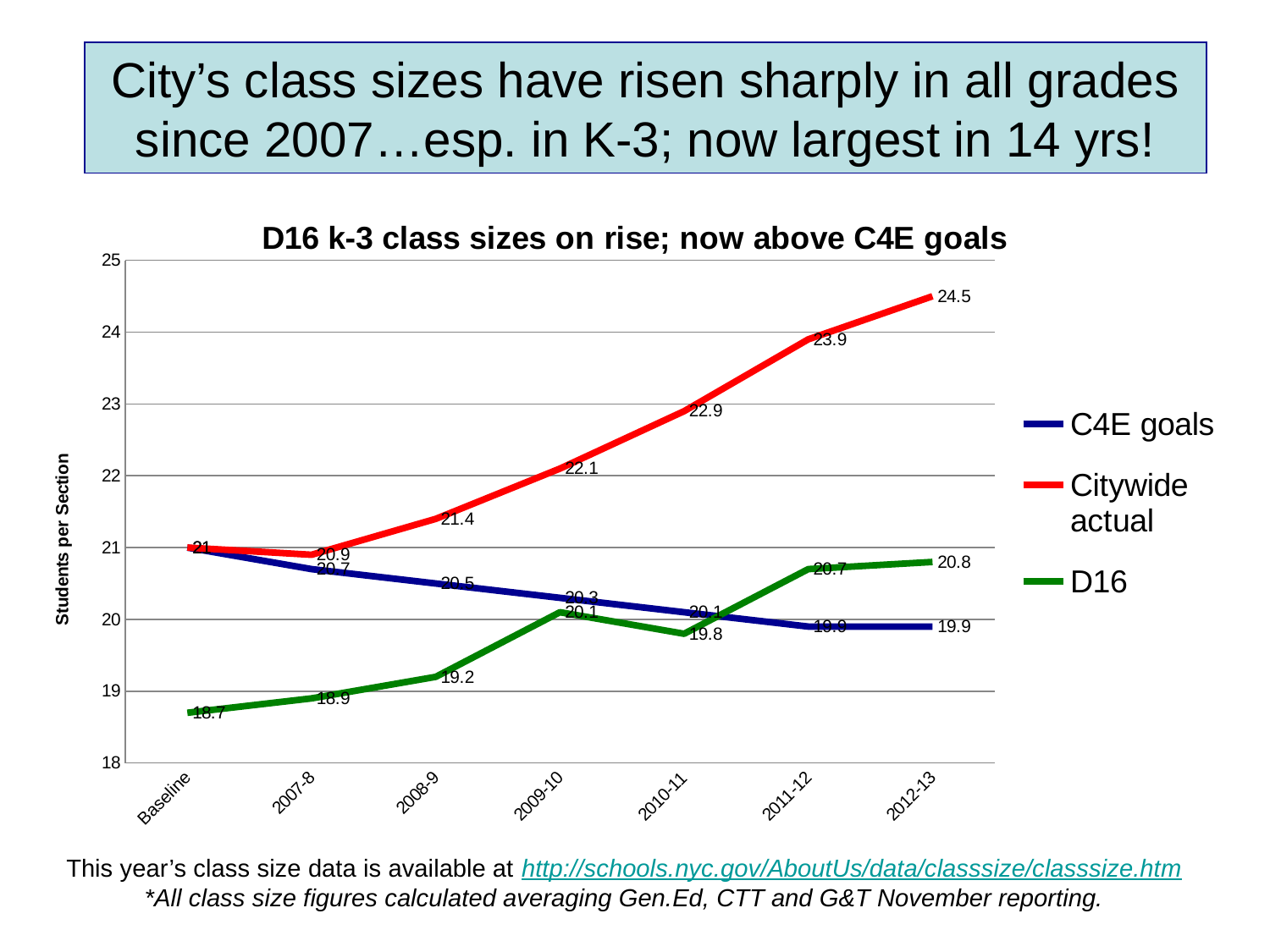
Which series has the highest value in 2012-13? Citywide actual What kind of chart is shown on the slide? Line chart How many points are plotted along the x axis for each series? 7 Is the Citywide actual value for 2010-11 greater or less than 22? greater What is the C4E goals value for 2012-13? 19.9 How many series does the legend list? 3 What is the difference between the Citywide actual value and the D16 value in 2012-13? 3.7 Does the C4E goals series rise or fall from Baseline to 2012-13? Fall What is the D16 value at Baseline? 18.7 What is the Citywide actual value for 2012-13? 24.5 For D16, which is larger: the value for 2010-11 or the value for 2011-12? 2011-12 What is the D16 value for 2008-9? 19.2